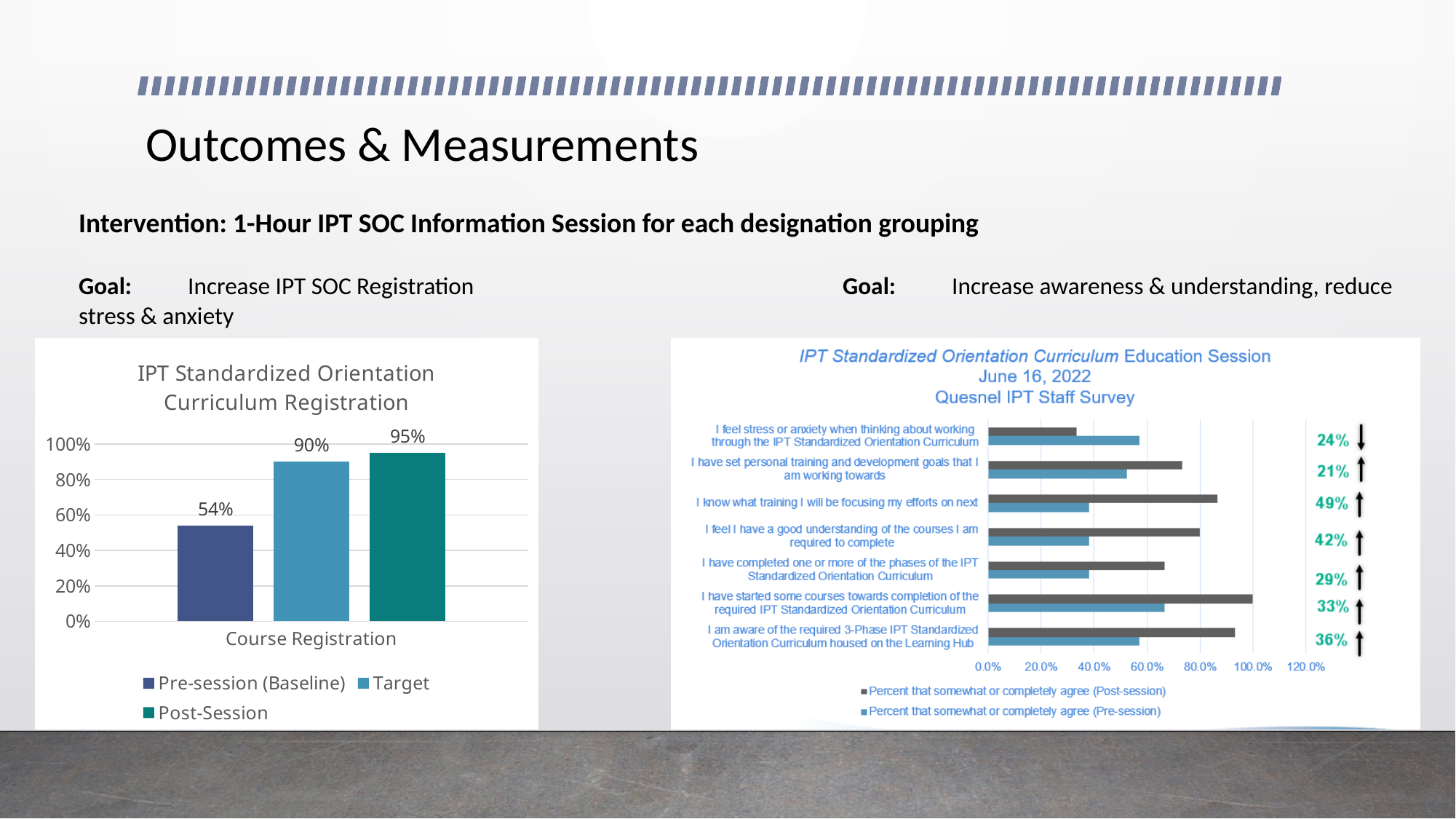
In the Quesnel IPT Staff Survey chart on the right, is the pre-session value for 'I have set personal training and development goals that I am working towards' greater or less than 40.0%? greater In the IPT Standardized Orientation Curriculum Registration chart, what is the Target value? 90% In the IPT Standardized Orientation Curriculum Registration chart, what is the difference between the Post-Session and Pre-session (Baseline) values? 41% How many series does the legend of the IPT Standardized Orientation Curriculum Registration chart list? 3 In the IPT Standardized Orientation Curriculum Registration chart, which series has the highest value? Post-Session In the IPT Standardized Orientation Curriculum Registration chart, is the Post-Session value larger or smaller than the Target value? larger In the IPT Standardized Orientation Curriculum Registration chart, what is the Pre-session (Baseline) value for Course Registration? 54% What kind of chart is the IPT Standardized Orientation Curriculum Registration chart? bar chart How many survey statements are plotted in the Quesnel IPT Staff Survey chart on the right? 7 In the Quesnel IPT Staff Survey chart on the right, what change is annotated next to 'I know what training I will be focusing my efforts on next'? 49% increase In the IPT Standardized Orientation Curriculum Registration chart, what is the Post-Session value? 95% In the Quesnel IPT Staff Survey chart on the right, is the post-session value for 'I have started some courses towards completion of the required IPT Standardized Orientation Curriculum' greater or less than 80.0%? greater